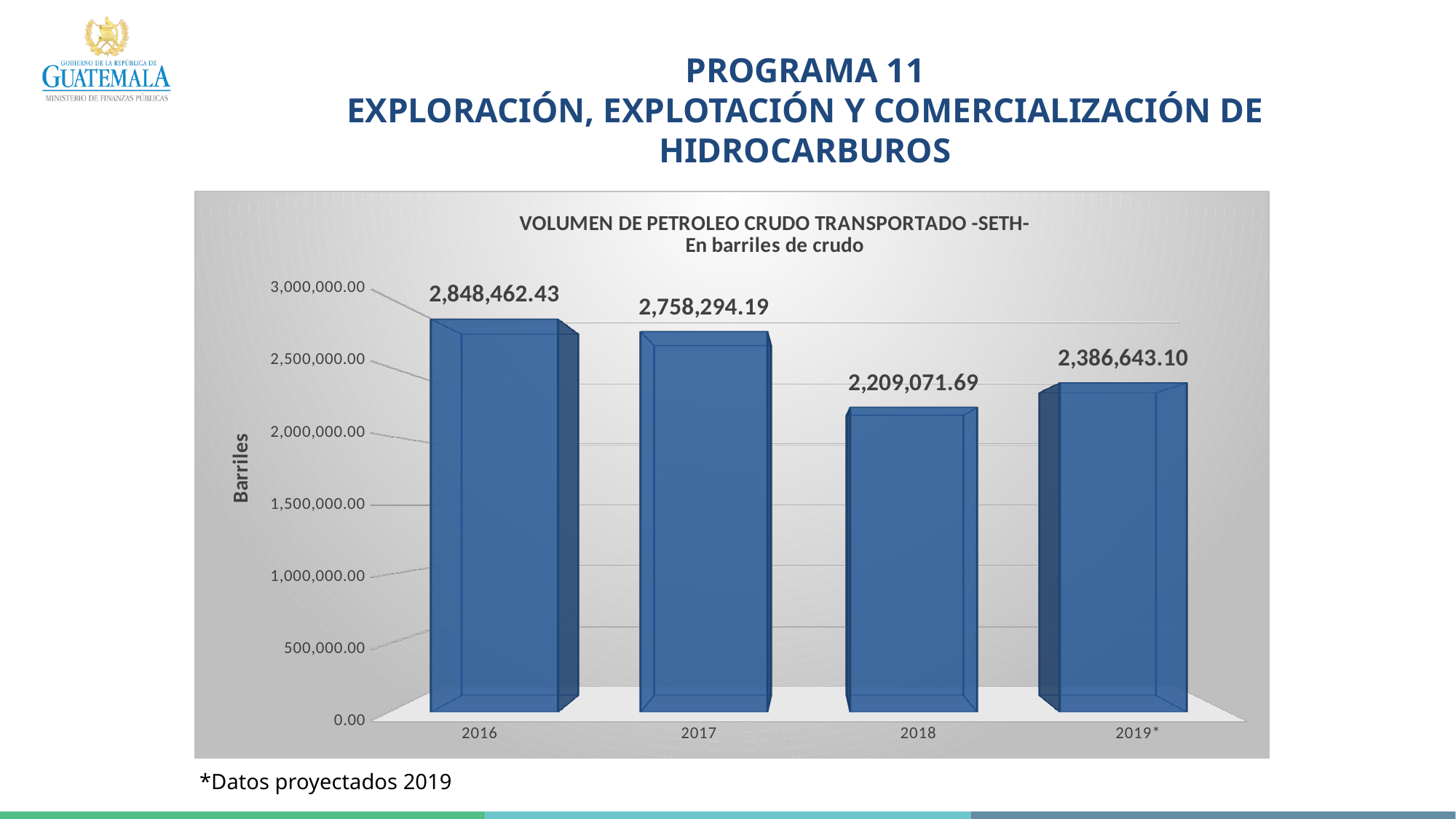
What kind of chart is shown on the slide? Bar chart What is the volume of crude oil transported in 2016? 2,848,462.43 What is the value shown for 2018? 2,209,071.69 Do the values rise or fall from 2016 to 2018? fall What is the projected value for 2019*? 2,386,643.10 By how much does the 2019* value exceed the 2018 value? 177,571.41 How many years are shown on the x axis? 4 Which year has the highest volume of crude oil transported? 2016 What is the difference between the 2016 and 2017 values? 90,168.24 Is the value for 2018 greater or less than 2,500,000.00? less Which is larger, the value for 2017 or the value for 2019*? 2017 Which year has the lowest volume of crude oil transported? 2018